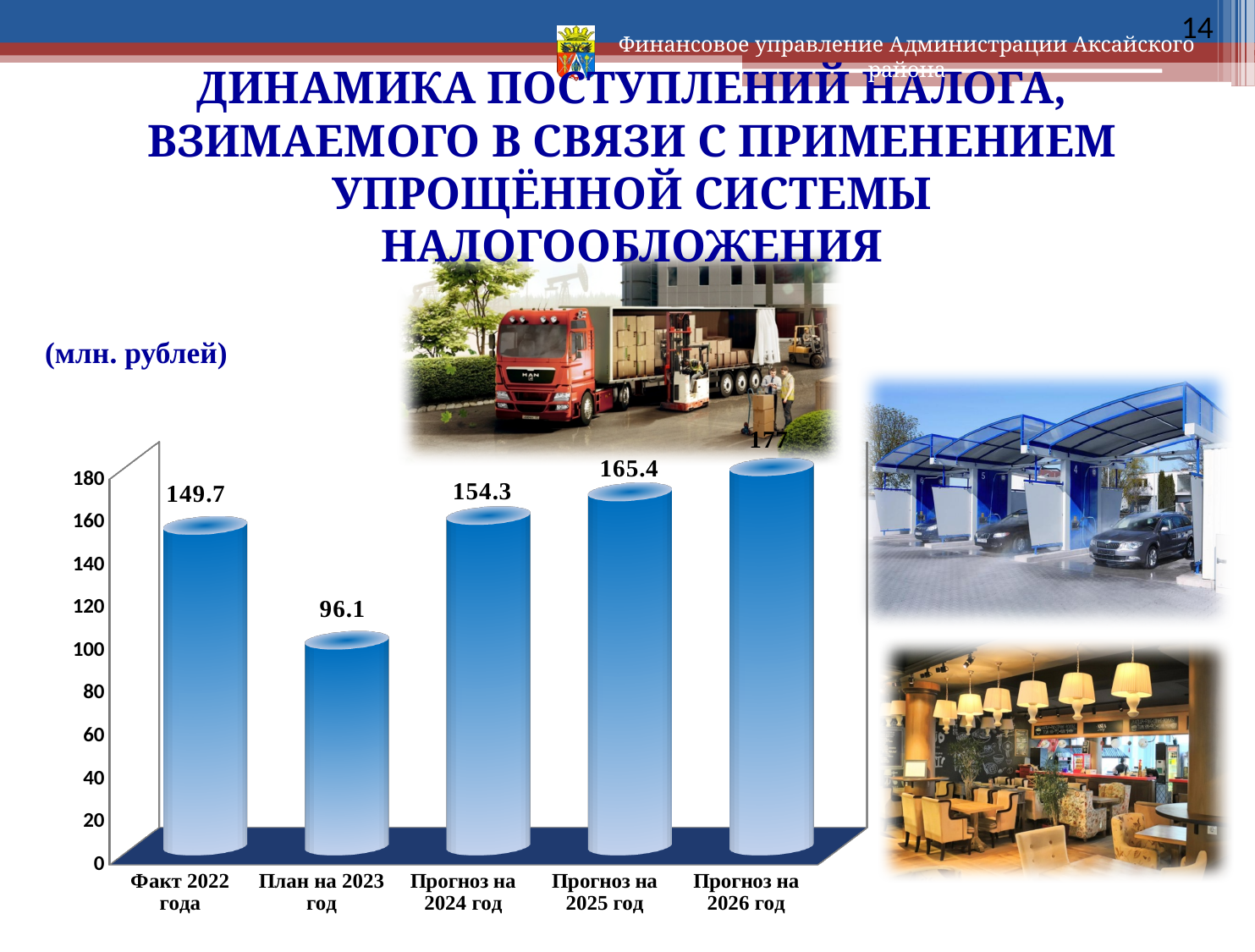
What is the value for План на 2023 год? 96.1 Which category has the highest value? Прогноз на 2026 год Is the value for План на 2023 год greater or less than 100? less What kind of chart is shown on the slide? bar chart What unit is indicated for the chart values? млн. рублей What is the value for Прогноз на 2026 год? 177 What is the value for Факт 2022 года? 149.7 What is the difference between the values for Прогноз на 2026 год and Прогноз на 2025 год? 11.6 Which is larger, the value for Факт 2022 года or the value for Прогноз на 2024 год? Прогноз на 2024 год What is the value for Прогноз на 2024 год? 154.3 Which category has the lowest value? План на 2023 год How many categories are shown on the chart? 5